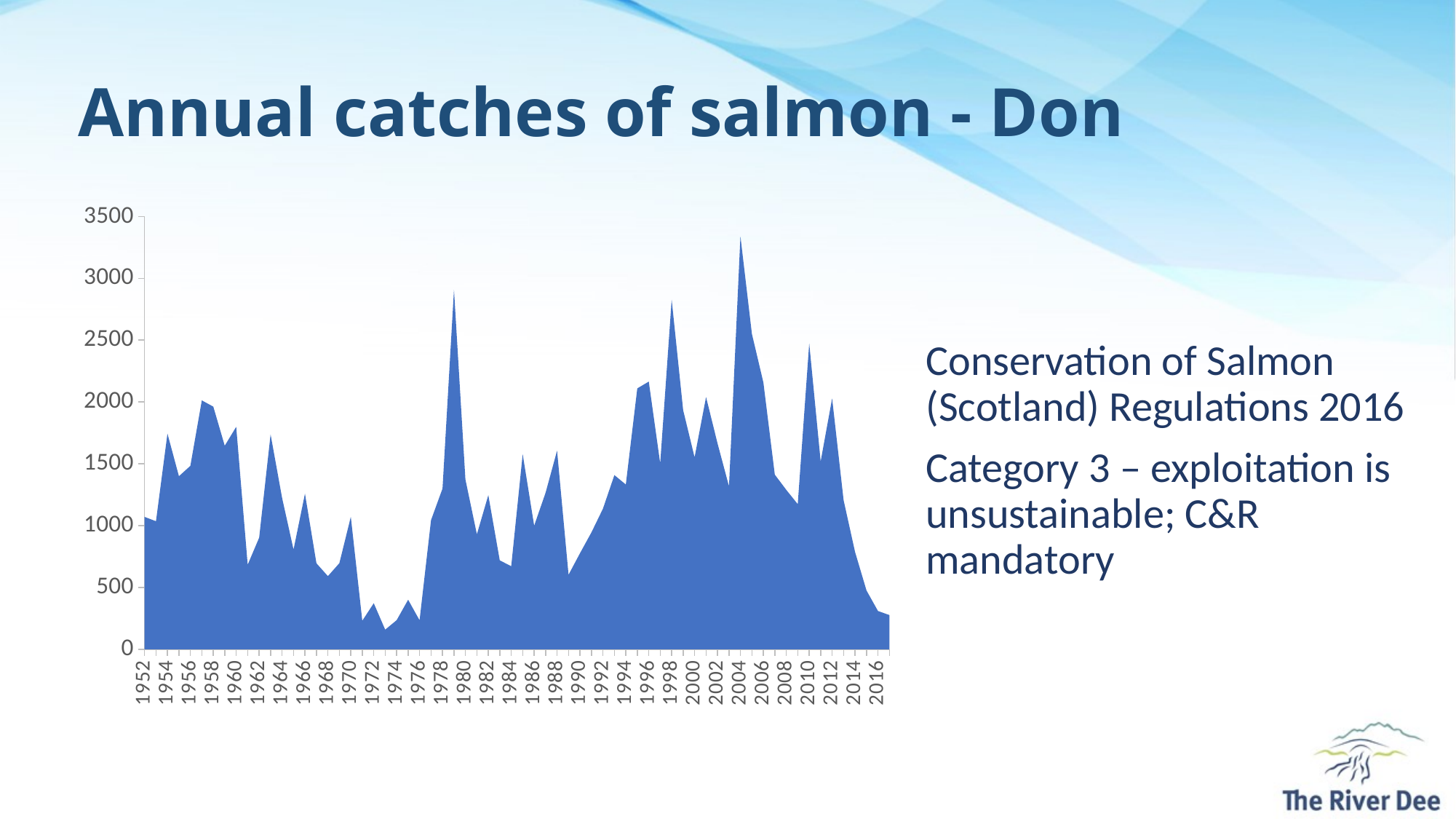
Is the value for 1972 greater or less than 500? less In which year does the chart reach its highest value? 2004 Is the value for 1990 greater or less than 1000? less What is the title of the chart? Annual catches of salmon - Don Is the value for 2016 greater or less than 500? less What is the highest value shown on the vertical axis? 3500 Which year has the larger value, 1952 or 1972? 1952 What kind of chart is shown on the slide? area chart Do the values rise or fall from 2012 to 2016? fall Which year has the larger value, 2004 or 1979? 2004